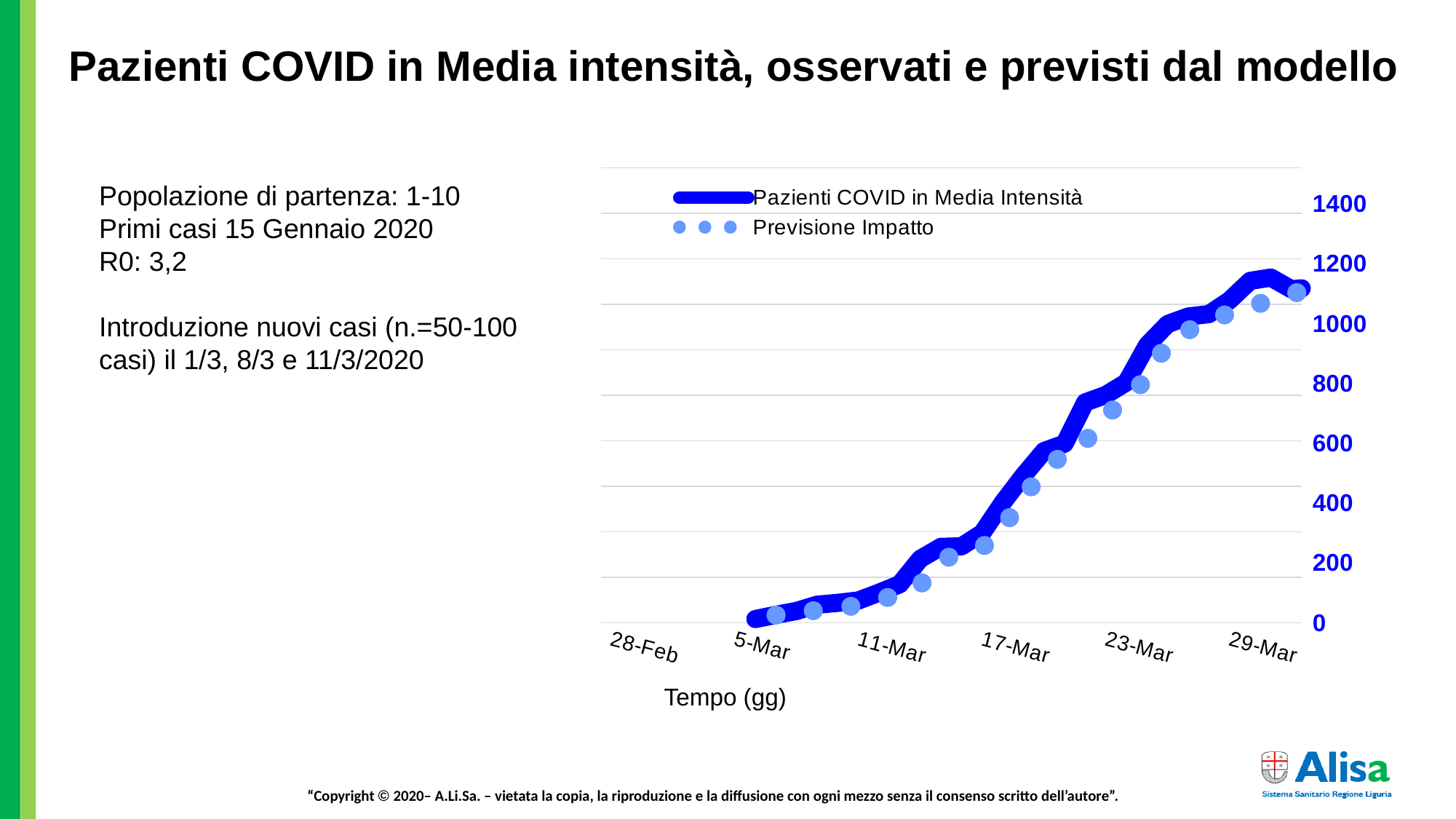
How many series does the legend list? 2 What are the two series named in the legend? Pazienti COVID in Media Intensità; Previsione Impatto Is the value of Pazienti COVID in Media Intensità at 11-Mar greater or less than 200? less Is the value of Pazienti COVID in Media Intensità at 29-Mar greater or less than 1000? greater Is the value of Pazienti COVID in Media Intensità at 17-Mar greater or less than 400? less Do the values of the Pazienti COVID in Media Intensità series rise or fall from 5-Mar to 29-Mar? rise What is the title of the x axis? Tempo (gg) What kind of chart is shown on the slide? line chart How many date labels are shown on the x axis? 6 What is the highest value shown on the y axis? 1400